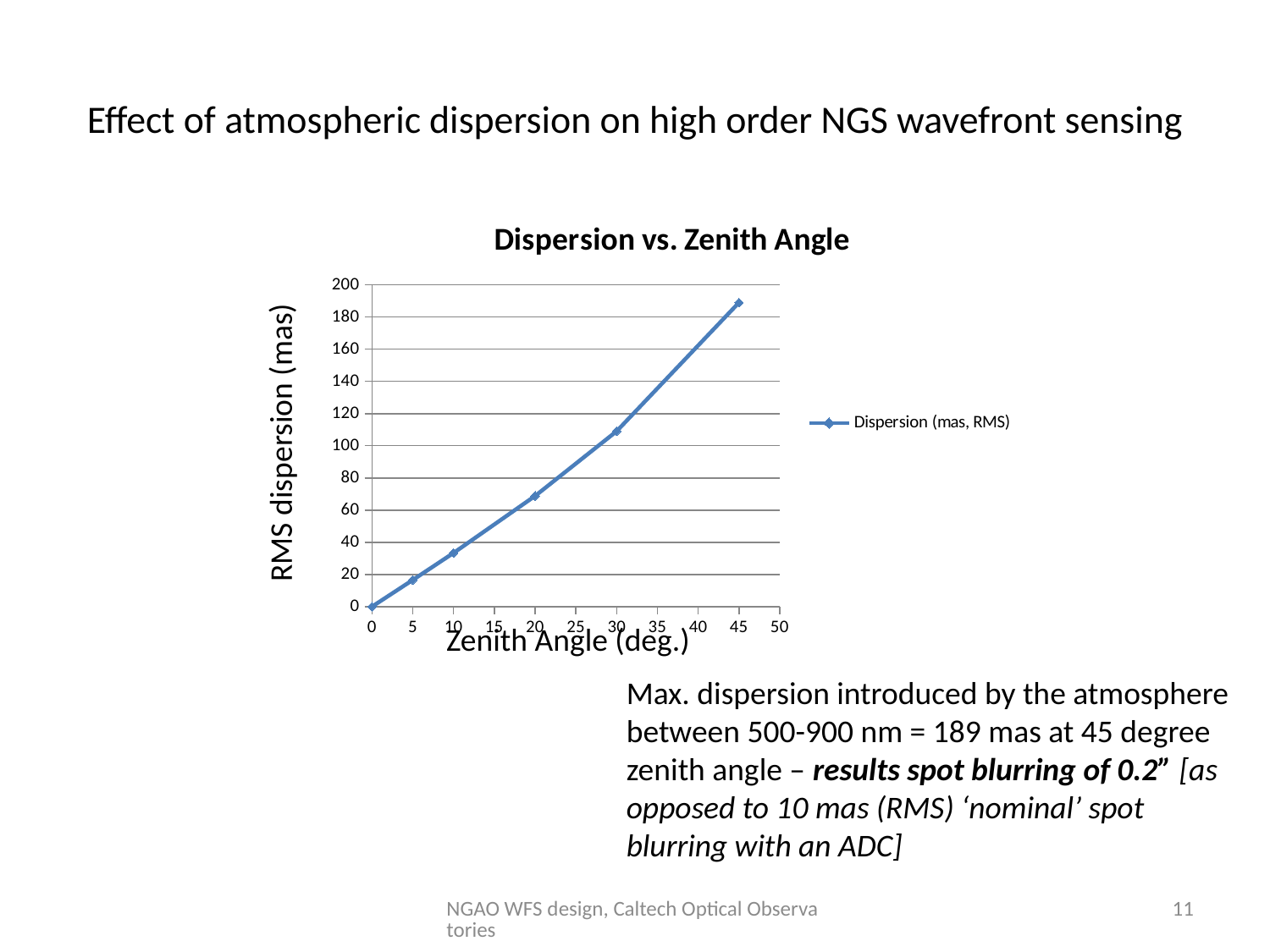
What kind of chart is shown on the slide? line chart What is the name of the series in the legend? Dispersion (mas, RMS) Is the RMS dispersion at a zenith angle of 30 degrees greater or less than 100? greater Does the RMS dispersion rise or fall as the zenith angle increases? rises What is the RMS dispersion at a zenith angle of 45 degrees, as stated on the slide? 189 mas How many series does the legend list? 1 Is the RMS dispersion at a zenith angle of 20 degrees greater or less than 80? less At which zenith angle is the RMS dispersion lowest? 0 At which zenith angle is the RMS dispersion highest? 45 What is the RMS dispersion at a zenith angle of 0 degrees? 0 What is the title of the chart? Dispersion vs. Zenith Angle How many data points are plotted on the line? 6